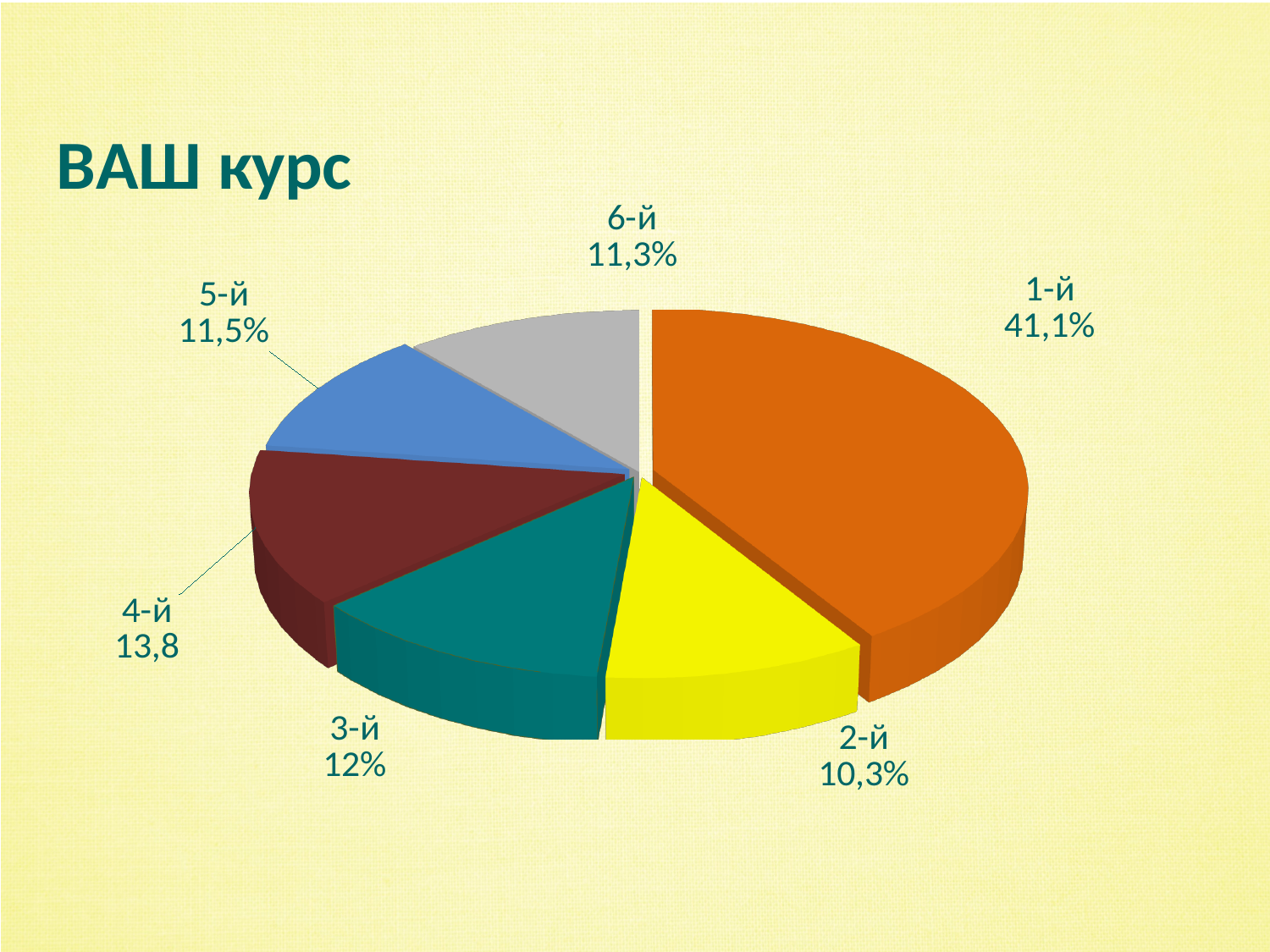
What is the difference between the shares of 1-й and 2-й? 30,8% What value is shown for the 2-й slice? 10,3% What value is labelled on the 4-й slice? 13,8 What kind of chart is shown on the slide? Pie chart What is the title of the chart? ВАШ курс Which course (курс) has the largest share of the pie? 1-й Which course has the smallest share of the pie? 2-й Which slice is larger, 3-й or 4-й? 4-й What percentage of the pie does the 1-й slice represent? 41,1% What percentage is shown for the 6-й slice? 11,3% Which slice is larger, 1-й or 5-й? 1-й How many slices does the pie chart have? 6